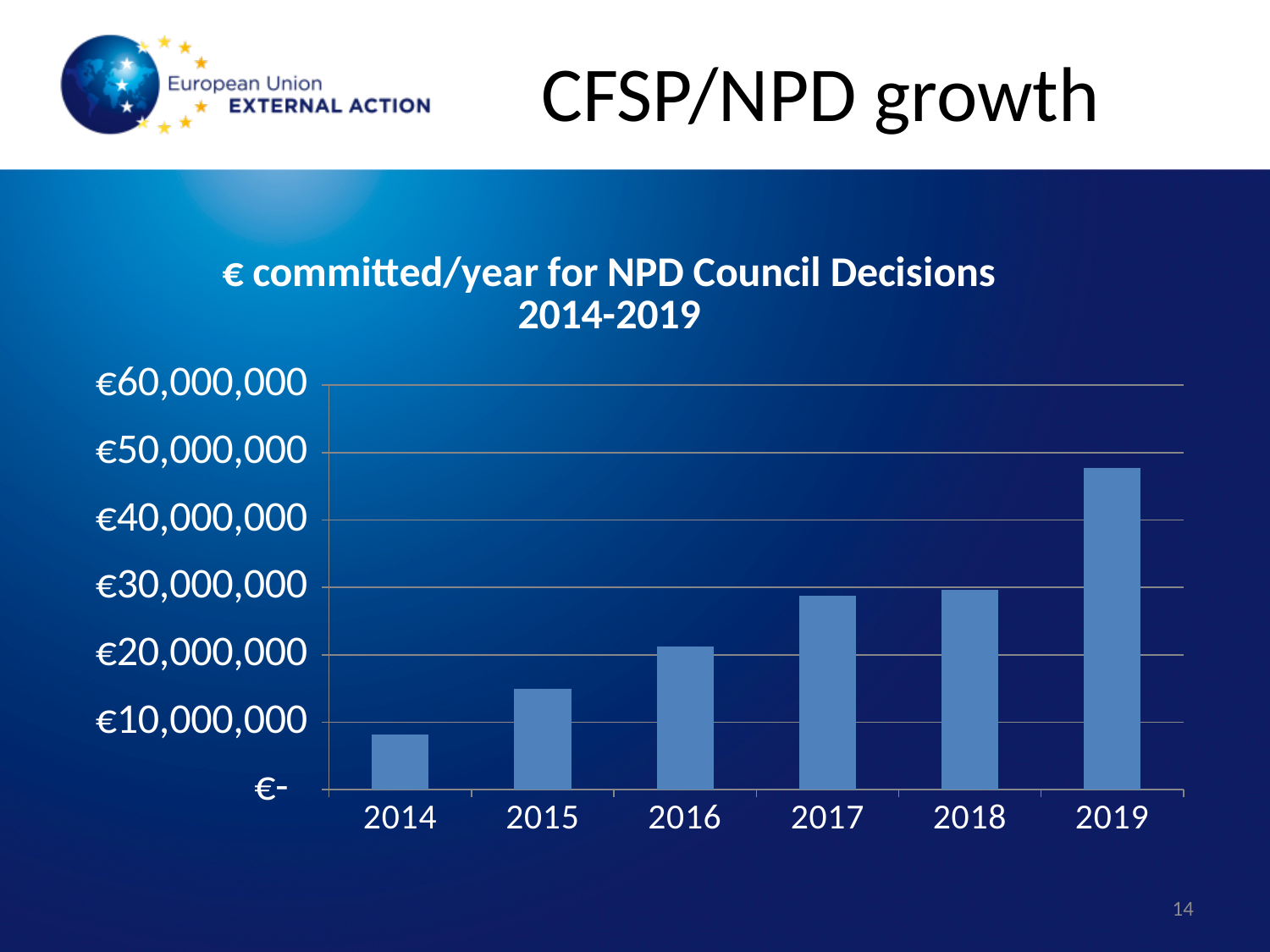
Is the value for 2019 greater or less than €40,000,000? greater What is the title of the chart? € committed/year for NPD Council Decisions 2014-2019 Which year has a larger amount committed, 2016 or 2019? 2019 Which year has the lowest amount committed? 2014 What type of chart is shown on the slide? bar chart Is the value for 2014 greater or less than €10,000,000? less Is the value for 2015 greater or less than €10,000,000? greater Which year has the highest amount committed? 2019 How many years are plotted on the chart? 6 Do the amounts committed rise or fall from 2014 to 2019? rise